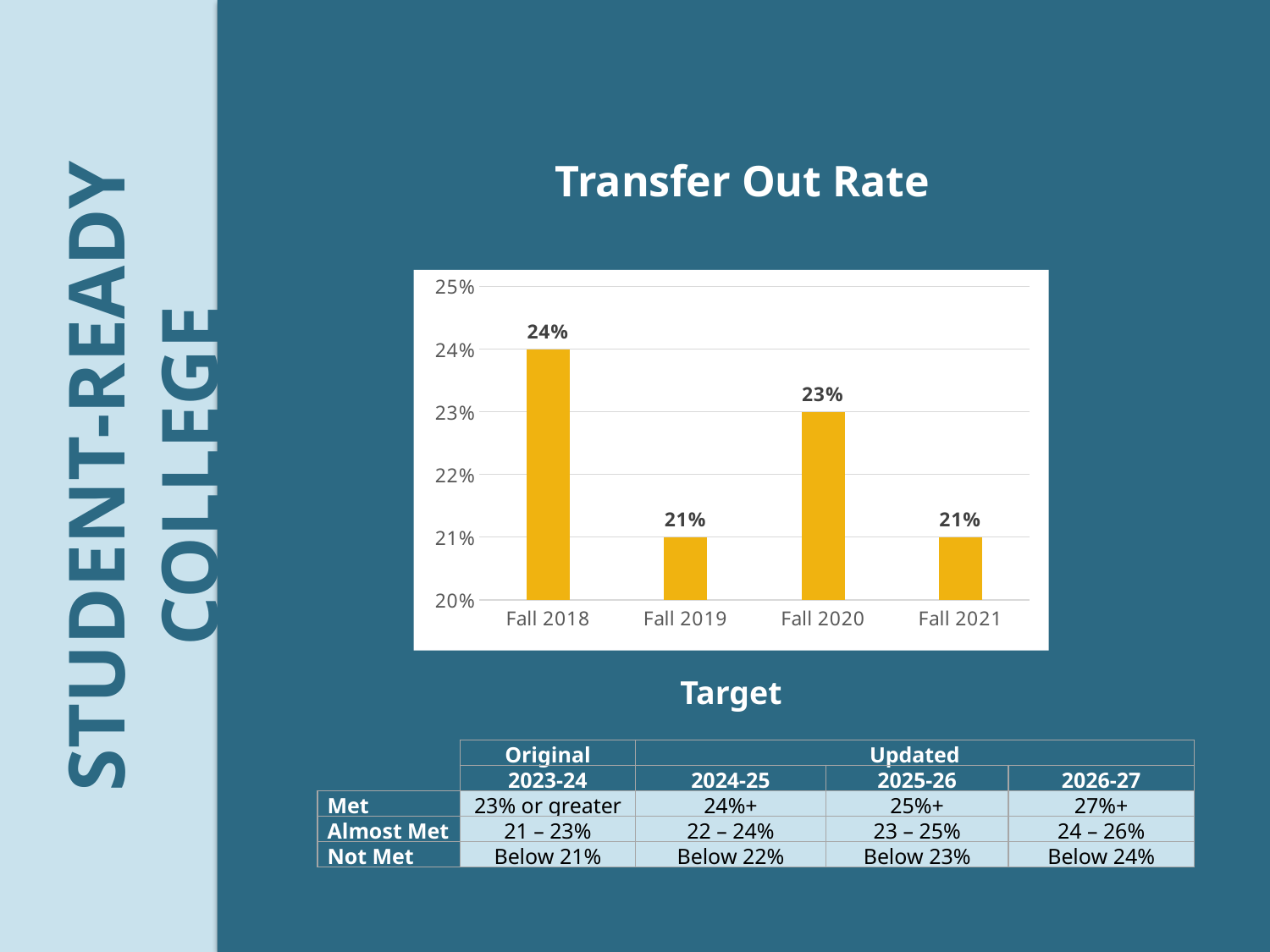
What is the transfer out rate for Fall 2021? 21% What kind of chart is used to show the Transfer Out Rate? Bar chart Which is larger, the transfer out rate for Fall 2019 or Fall 2020? Fall 2020 What is the title of the chart on the slide? Transfer Out Rate Does the transfer out rate rise or fall from Fall 2020 to Fall 2021? Fall Which term has the highest transfer out rate? Fall 2018 What is the transfer out rate for Fall 2018? 24% What is the difference in transfer out rate between Fall 2020 and Fall 2021? 2% Is the transfer out rate for Fall 2018 greater or less than 23%? greater What is the transfer out rate for Fall 2020? 23% What is the difference in transfer out rate between Fall 2018 and Fall 2019? 3% How many terms are shown on the Transfer Out Rate chart? 4